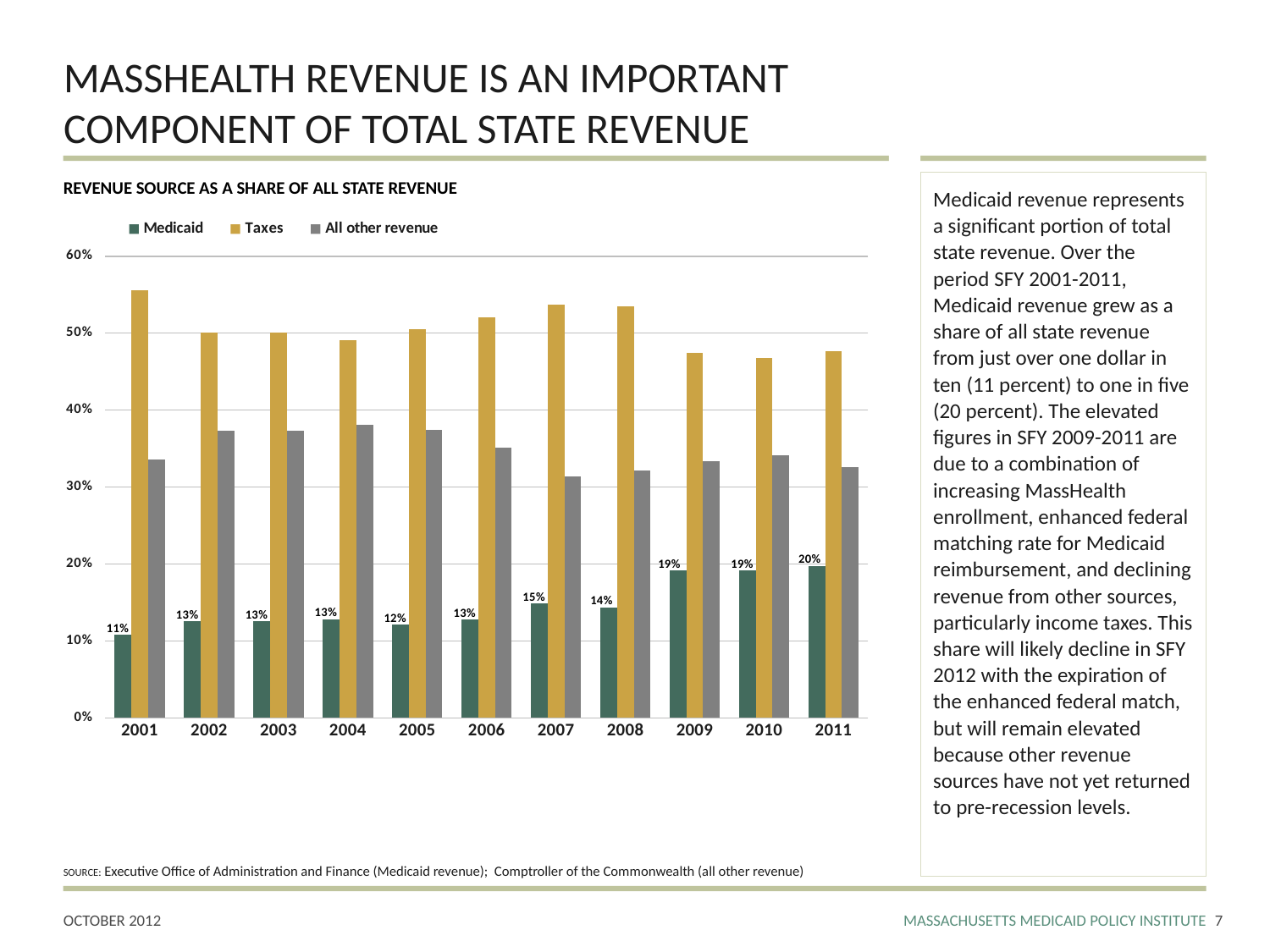
Is the value for Taxes in 2001 greater or less than 50%? greater By how many percentage points did the Medicaid share of all state revenue increase from 2001 to 2011? 9 percentage points How many years are shown on the x axis of the chart? 11 Which year has the larger Medicaid share of all state revenue, 2007 or 2008? 2007 What is the Medicaid share of all state revenue in 2007? 15% How many series does the chart's legend list? 3 In which year is the Medicaid share of all state revenue highest? 2011 Is the value for Taxes in 2010 greater or less than 50%? less What is the Medicaid share of all state revenue in 2011? 20% In which year is the Medicaid share of all state revenue lowest? 2001 What share of all state revenue did Medicaid represent in 2001? 11% Does the Medicaid share of all state revenue generally rise or fall from 2001 to 2011? rise